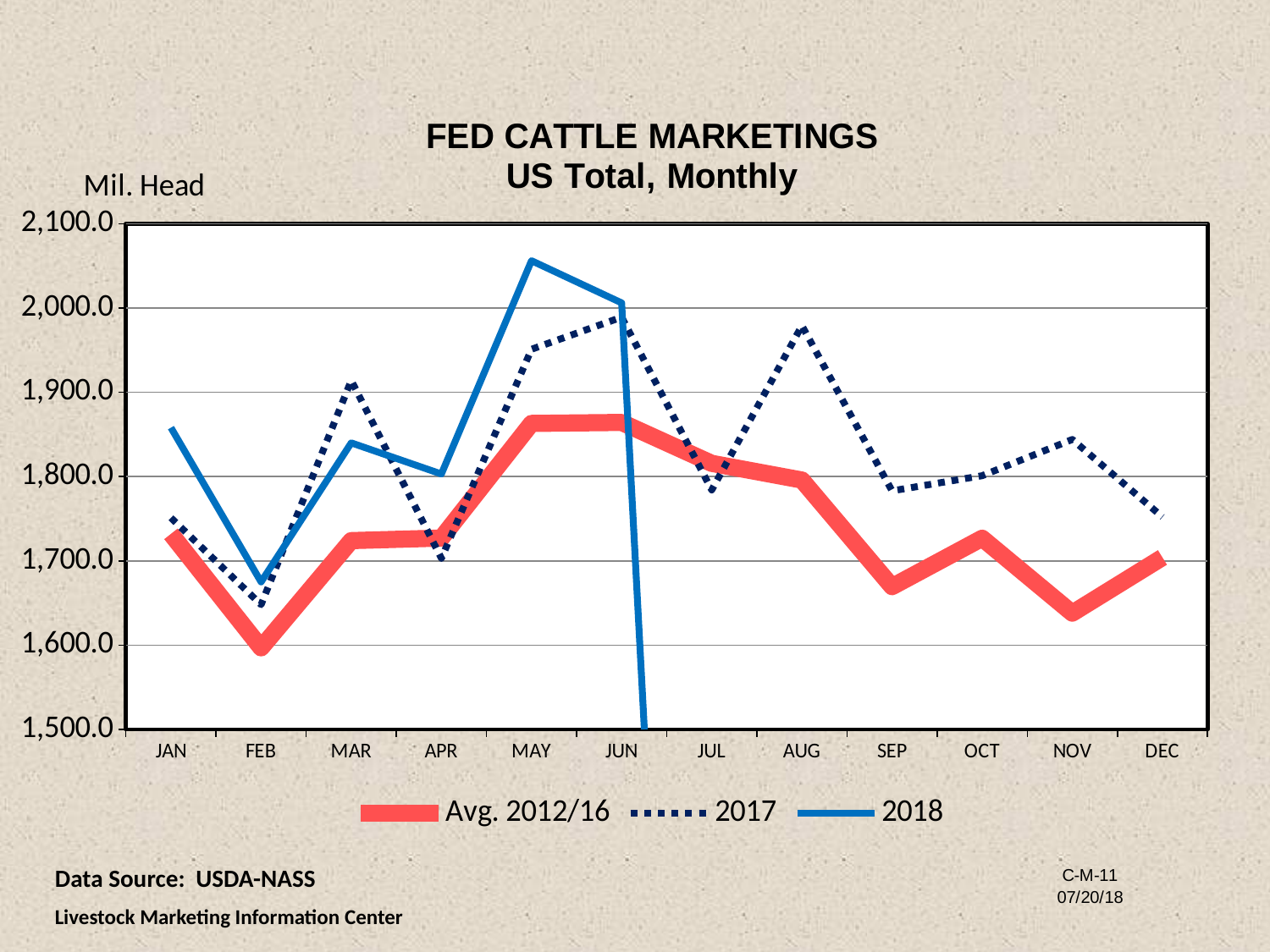
In MAY, which series is higher: 2018 or 2017? 2018 Does the 2018 series rise or fall from JAN to FEB? fall How many series does the legend list? 3 What kind of chart is shown on the slide? line chart In which month is the Avg. 2012/16 series at its lowest? FEB Is the 2018 value for MAY greater or less than 2,000.0? greater How many months are shown along the x axis? 12 What is the label on the y axis of the chart? Mil. Head In which month does the 2018 series reach its highest value? MAY Is the 2017 value for AUG greater or less than 1,900.0? greater In which month is the 2017 series at its lowest? FEB Is the Avg. 2012/16 value for SEP greater or less than 1,700.0? less